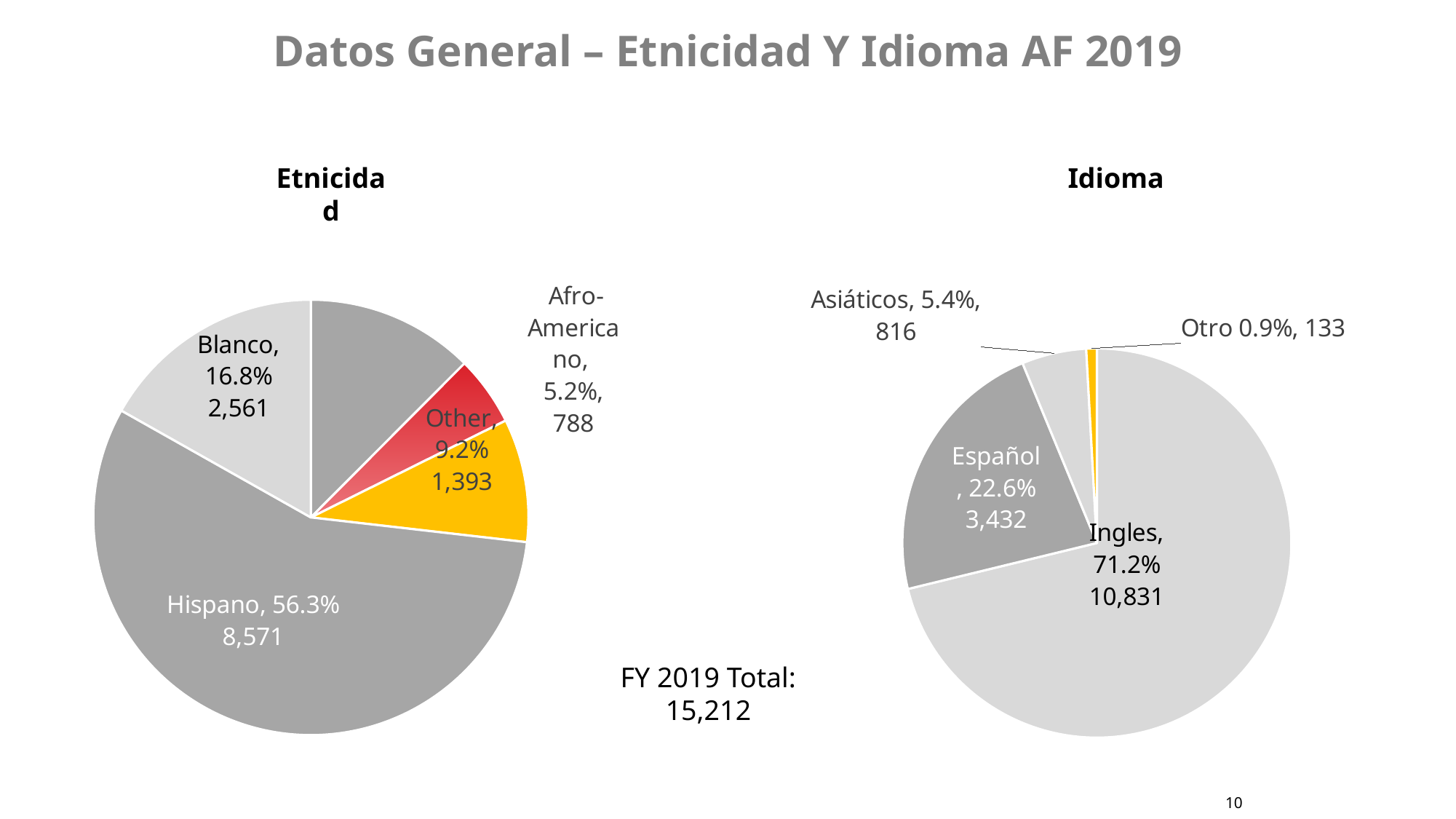
In the Etnicidad chart, what share of the pie is Blanco? 16.8% In the Idioma chart, which category has the smallest slice? Otro In the Idioma chart, what is the value for Ingles? 10,831 What type of chart is the Etnicidad chart? pie chart In the Etnicidad chart, what is the difference between the Hispano and Blanco values? 6,010 In the Idioma chart, what share of the pie is Español? 22.6% In the Idioma chart, which is larger, Asiáticos or Otro? Asiáticos In the Etnicidad chart, which labelled category has the largest slice? Hispano In the Idioma chart, how many slices are there? 4 In the Etnicidad chart, what is the value for Afro-Americano? 788 In the Etnicidad chart, what is the value for Hispano? 8,571 In the Idioma chart, what is the difference between the Ingles and Español values? 7,399